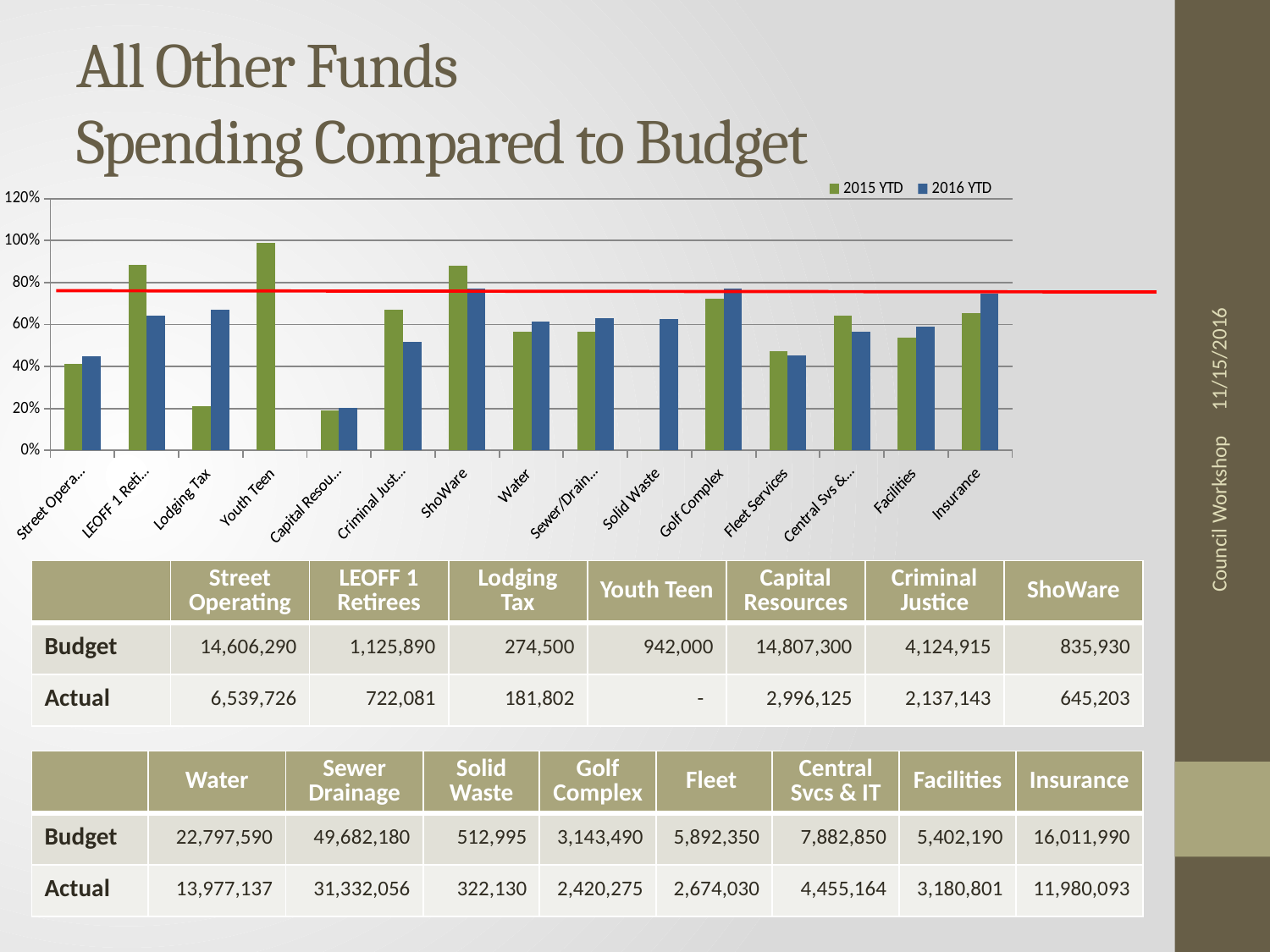
Which is larger: the 2015 YTD bar for Capital Resources or the 2015 YTD bar for Criminal Justice? Criminal Justice How many fund categories are shown along the x axis of the chart? 15 How many series does the chart legend list? 2 Is the 2015 YTD value for Lodging Tax greater or less than 40%? less Is the 2015 YTD value for LEOFF 1 Retirees greater or less than 80%? greater Is the 2016 YTD value for Capital Resources greater or less than 40%? less Which category has the highest 2015 YTD bar? Youth Teen For Lodging Tax, which is larger: the 2015 YTD bar or the 2016 YTD bar? 2016 YTD What are the two series named in the chart legend? 2015 YTD and 2016 YTD What kind of chart is shown on the slide? bar chart